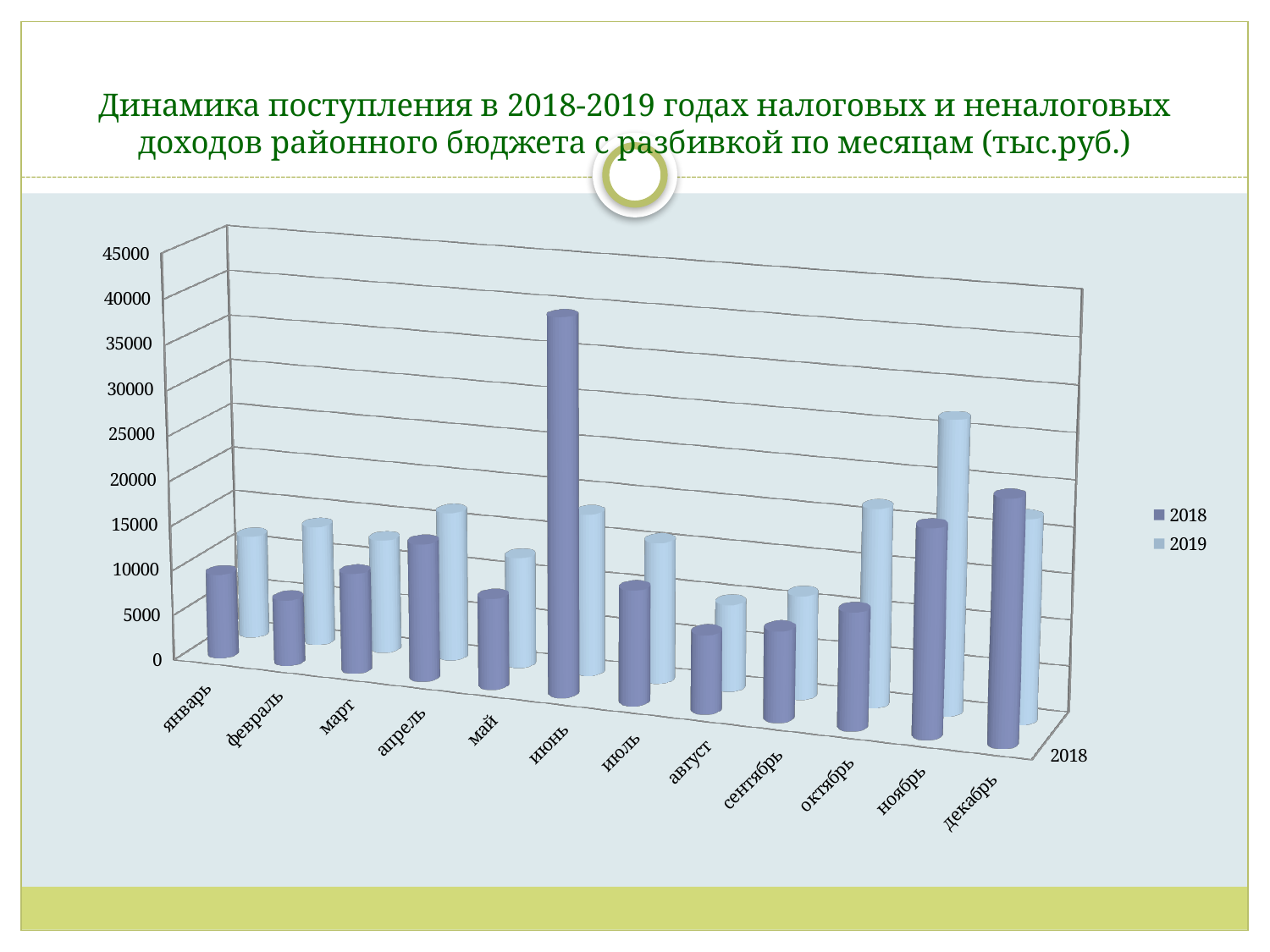
Which series is shown in the darker blue bars according to the legend? 2018 Is the value for февраль in the 2018 series greater or less than 10000? less For июнь, which series has the larger value, 2018 or 2019? 2018 Which month has the highest value for the 2018 series? июнь For ноябрь, which series has the larger value, 2018 or 2019? 2019 How many months are shown along the x axis? 12 Is the value for ноябрь in the 2019 series greater or less than 20000? greater Is the value for июнь in the 2018 series greater or less than 30000? greater How many series does the legend list? 2 What kind of chart is shown on the slide? bar chart Which month has the highest value for the 2019 series? ноябрь For октябрь, which series has the larger value, 2018 or 2019? 2019